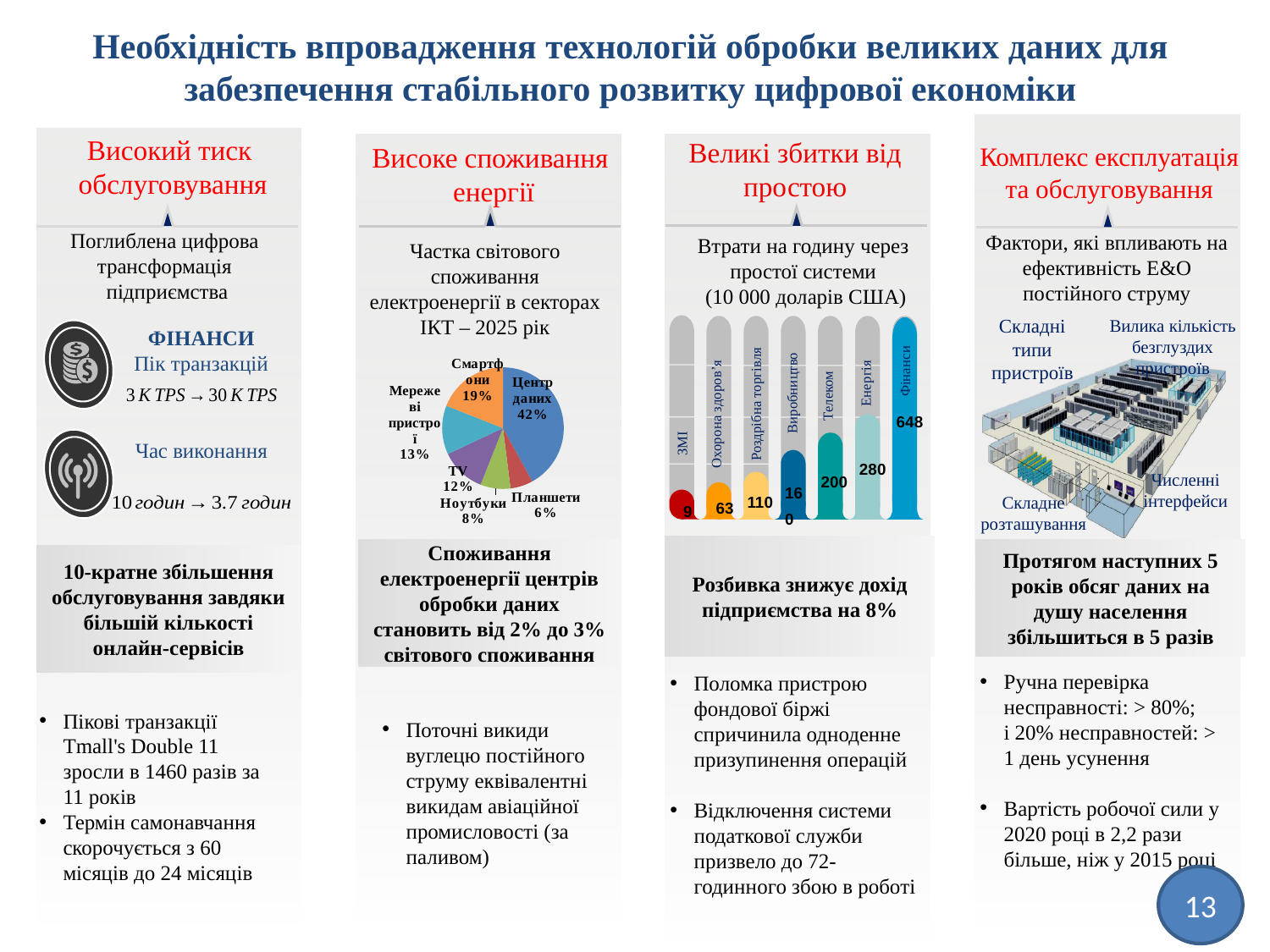
In the pie chart 'Частка світового споживання електроенергії в секторах ІКТ – 2025 рік', what share is shown for Центр даних? 42% In the pie chart 'Частка світового споживання електроенергії в секторах ІКТ – 2025 рік', which category has the largest share? Центр даних In the pie chart 'Частка світового споживання електроенергії в секторах ІКТ – 2025 рік', how much larger is the share of Смартфони than the share of Планшети? 13% In the bar chart 'Втрати на годину через простої системи', which sector has the lowest value? ЗМІ In the pie chart 'Частка світового споживання електроенергії в секторах ІКТ – 2025 рік', how many categories are shown? 6 In the pie chart 'Частка світового споживання електроенергії в секторах ІКТ – 2025 рік', which category has the smallest share? Планшети In the bar chart 'Втрати на годину через простої системи', which sector has the highest value? Фінанси What kind of chart is used for 'Частка світового споживання електроенергії в секторах ІКТ – 2025 рік'? Pie chart In the bar chart 'Втрати на годину через простої системи', do the values rise or fall from left to right? Rise In the bar chart 'Втрати на годину через простої системи', what is the difference between the values for Енергія and Телеком? 80 In the bar chart 'Втрати на годину через простої системи', what is the value for Фінанси? 648 In the bar chart 'Втрати на годину через простої системи', which is larger: Роздрібна торгівля or Охорона здоров'я? Роздрібна торгівля